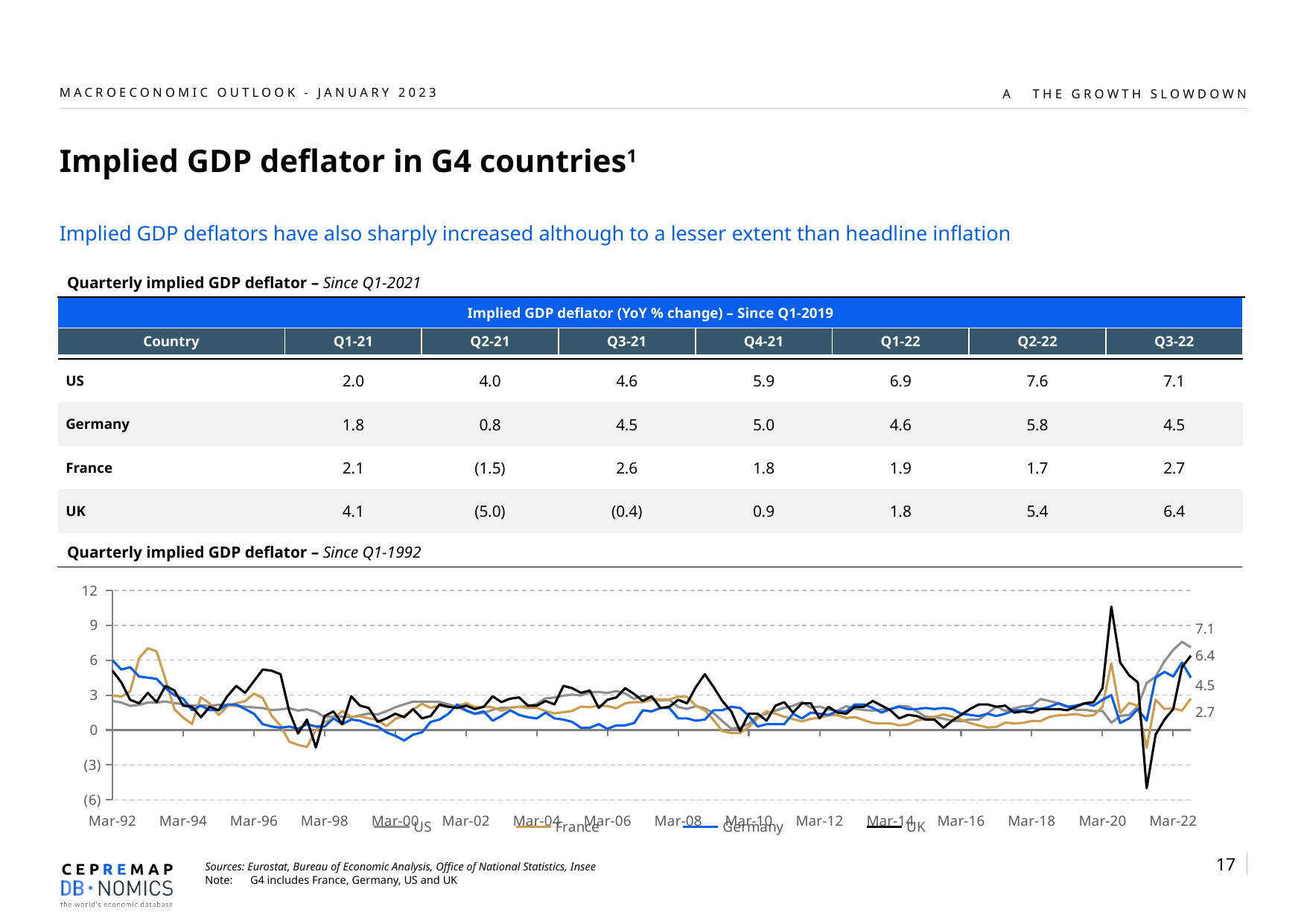
In the line chart, which is larger at the end of the series: the UK value or the Germany value? UK In the line chart, which country has the highest value at the end of the series? US In the line chart, what is the difference between the latest labelled values for the US and France? 4.4 In the line chart, what is the latest labelled value for the US series? 7.1 How many series does the legend of the line chart list? 4 In the line chart, what colour is the UK line? Black In the line chart, is the UK peak around Mar-20 greater or less than 9? greater In the line chart, what is the latest labelled value for the Germany series? 4.5 In the line chart, what is the latest labelled value for the UK series? 6.4 In the line chart, which country has the lowest value at the end of the series? France In the line chart, what is the latest labelled value for the France series? 2.7 What kind of chart is shown under 'Quarterly implied GDP deflator – Since Q1-1992'? Line chart